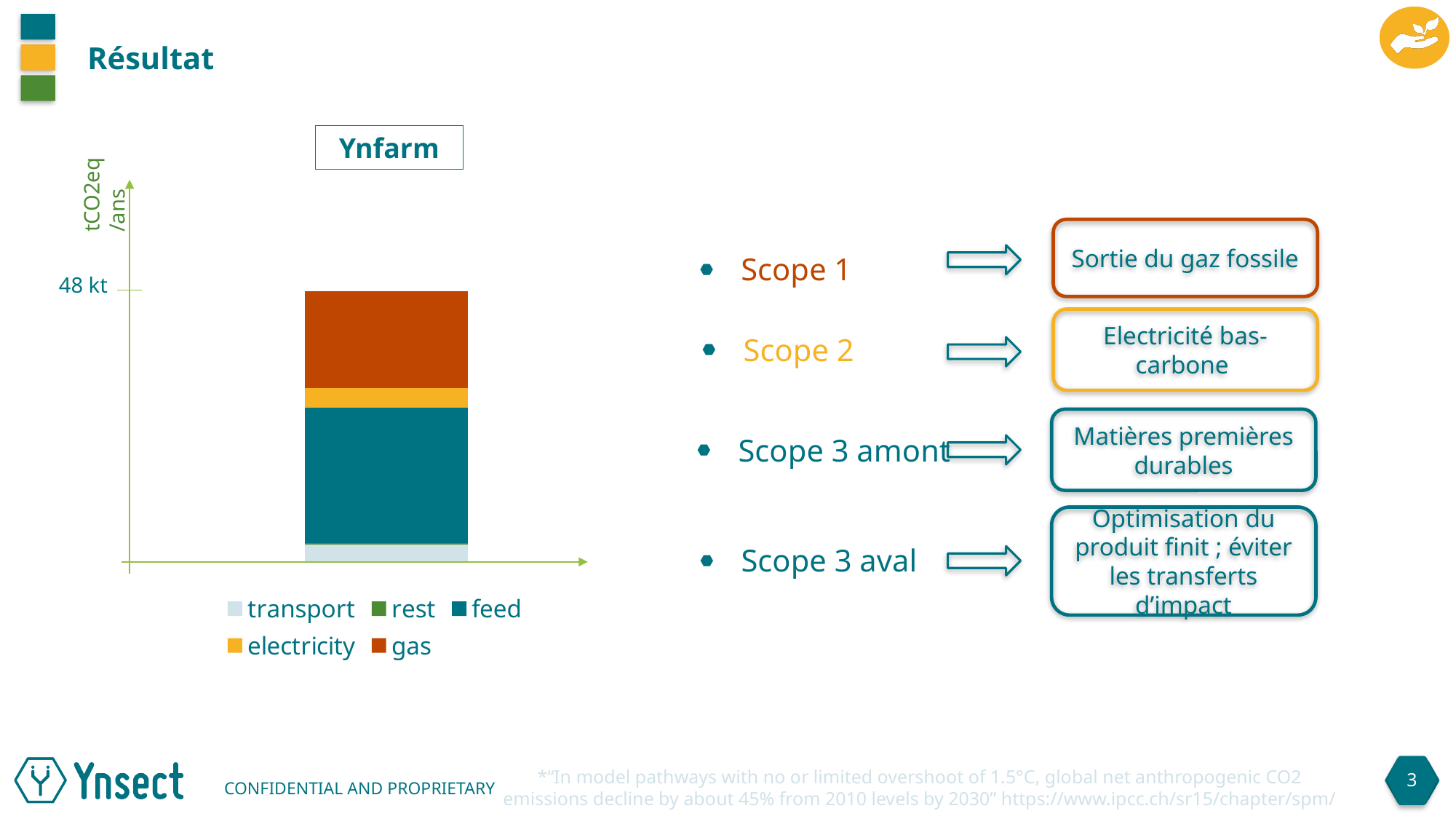
What is the label on the vertical axis of the chart? tCO2eq /ans How many series does the chart legend list? 5 Which segment of the Ynfarm bar is the smallest? rest Which segment of the Ynfarm bar is the largest? feed What is the title of the chart? Ynfarm What kind of chart is shown on the slide? stacked bar chart Which segment is larger in the Ynfarm bar, feed or rest? feed What is the total value of the Ynfarm stacked bar? 48 kt How many bars are plotted in the chart? 1 Which segment is larger in the Ynfarm bar, feed or gas? feed Which segment is larger in the Ynfarm bar, gas or electricity? gas